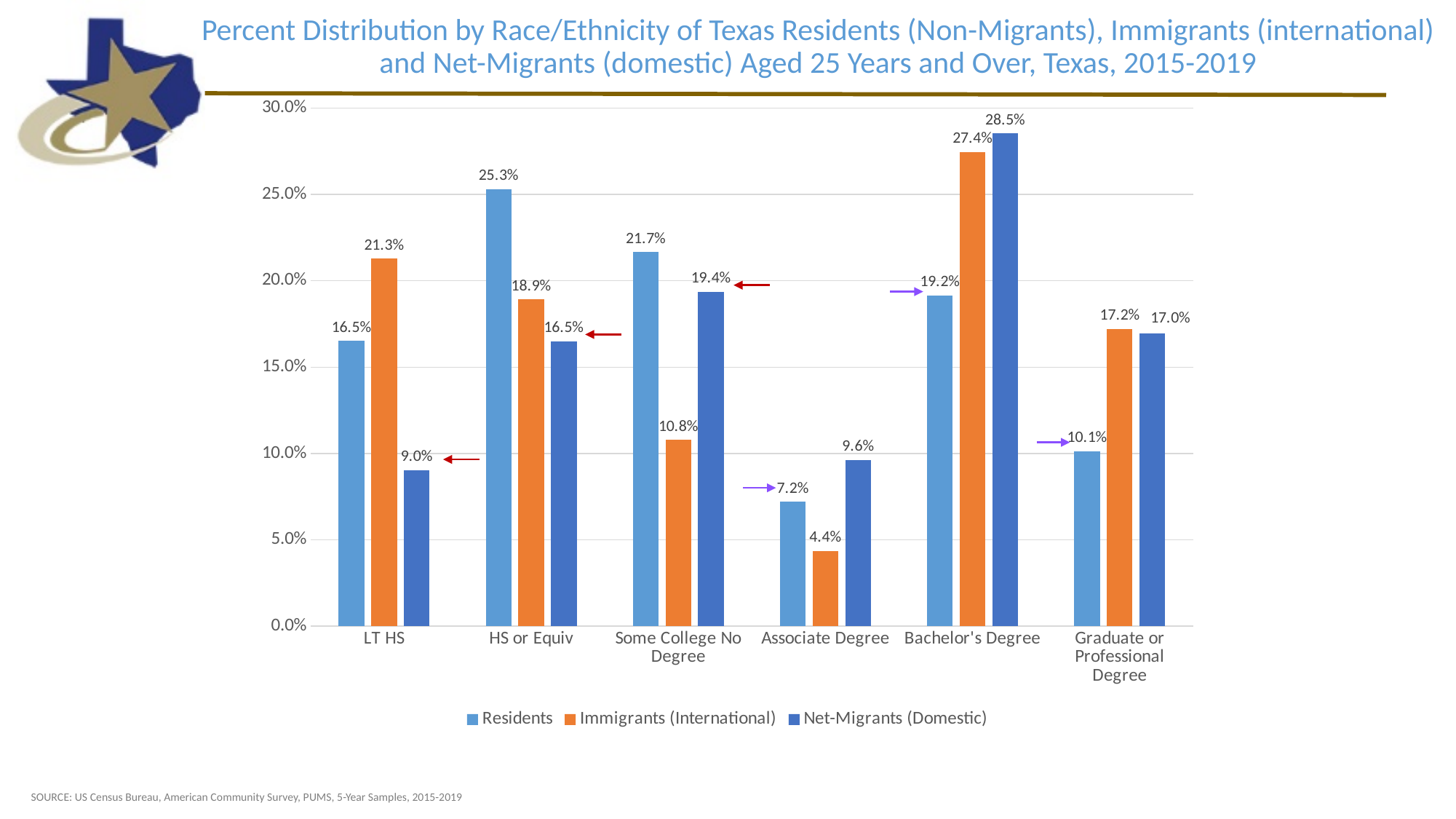
What is the value for Residents in the Some College No Degree category? 21.7% What is the difference between the Immigrants (International) and Residents values in the Bachelor's Degree category? 8.2% In the Associate Degree category, which series has the larger value: Residents or Net-Migrants (Domestic)? Net-Migrants (Domestic) Which category has the lowest value for Immigrants (International)? Associate Degree Which series is shown in orange in the legend? Immigrants (International) What is the value for Net-Migrants (Domestic) in the Bachelor's Degree category? 28.5% What is the difference between the Residents and Net-Migrants (Domestic) values in the LT HS category? 7.5% What kind of chart is shown on the slide? Bar chart Which category has the highest value for Residents? HS or Equiv How many education categories are shown on the x axis? 6 What is the value for Immigrants (International) in the LT HS category? 21.3% How many series does the legend list? 3